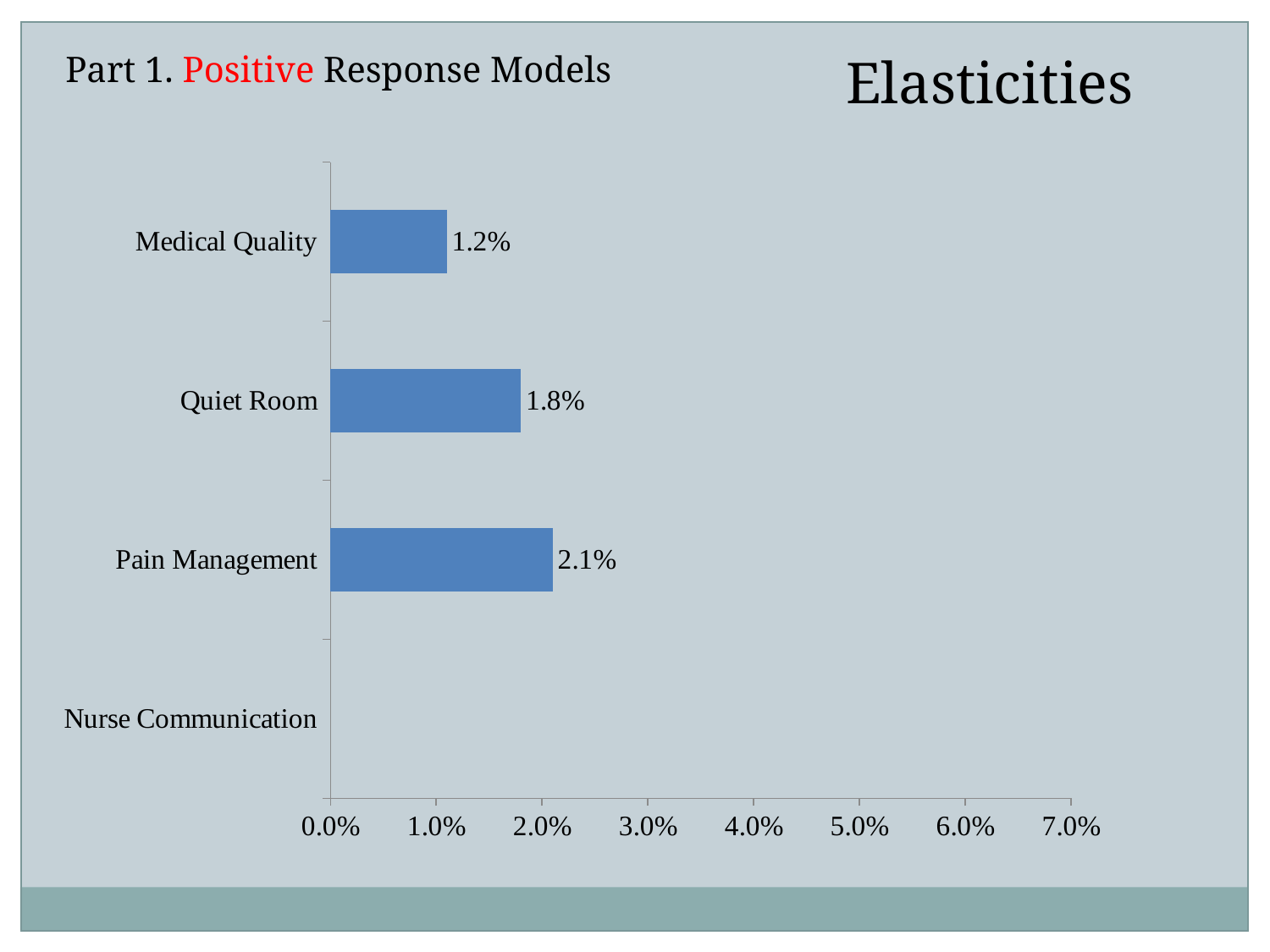
Is the value for Medical Quality greater or less than 2.0%? less What is the difference between the values for Pain Management and Medical Quality? 0.9% What is the title shown at the top right of the slide above the chart? Elasticities Among the categories with a bar shown, which has the lowest value? Medical Quality How many categories are listed on the vertical axis? 4 What is the value for Medical Quality? 1.2% What is the value for Quiet Room? 1.8% What is the difference between the values for Quiet Room and Medical Quality? 0.6% Which is larger, the value for Quiet Room or the value for Medical Quality? Quiet Room What is the value for Pain Management? 2.1% Which category has the highest value? Pain Management What kind of chart is shown on the slide? bar chart